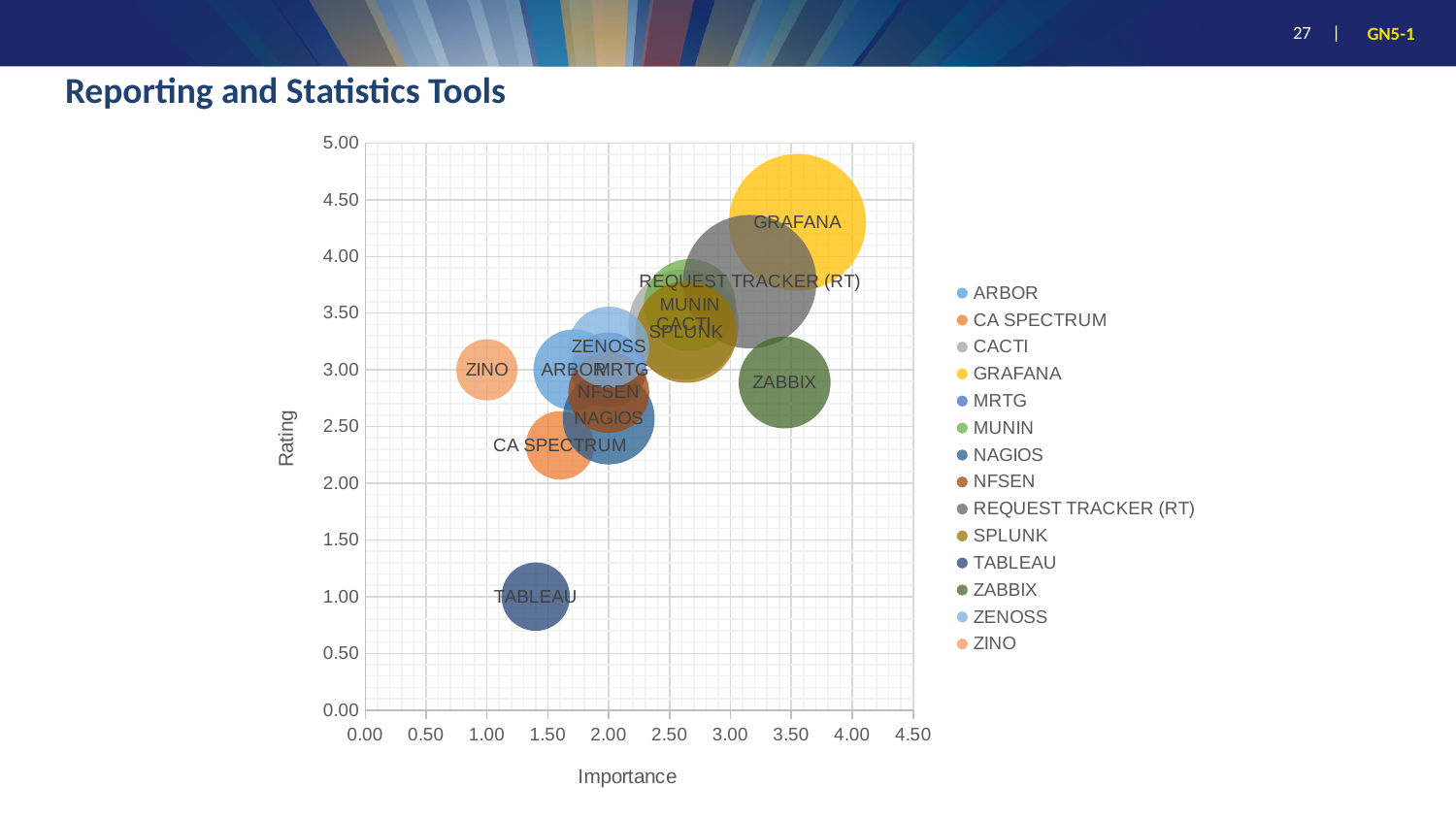
Is the importance for ZABBIX greater or less than 3.00? greater Which has the higher rating, GRAFANA or ZABBIX? GRAFANA Which tool has the lowest importance? ZINO Is the rating for TABLEAU greater or less than 1.50? less Which tool has the lowest rating? TABLEAU What kind of chart is shown on the slide? Bubble chart Which tool has the highest rating? GRAFANA What is the label of the horizontal axis? Importance Which has the higher rating, ZINO or TABLEAU? ZINO Is the rating for GRAFANA greater or less than 4.00? greater How many bubbles are plotted on the chart? 14 How many tools does the legend list? 14